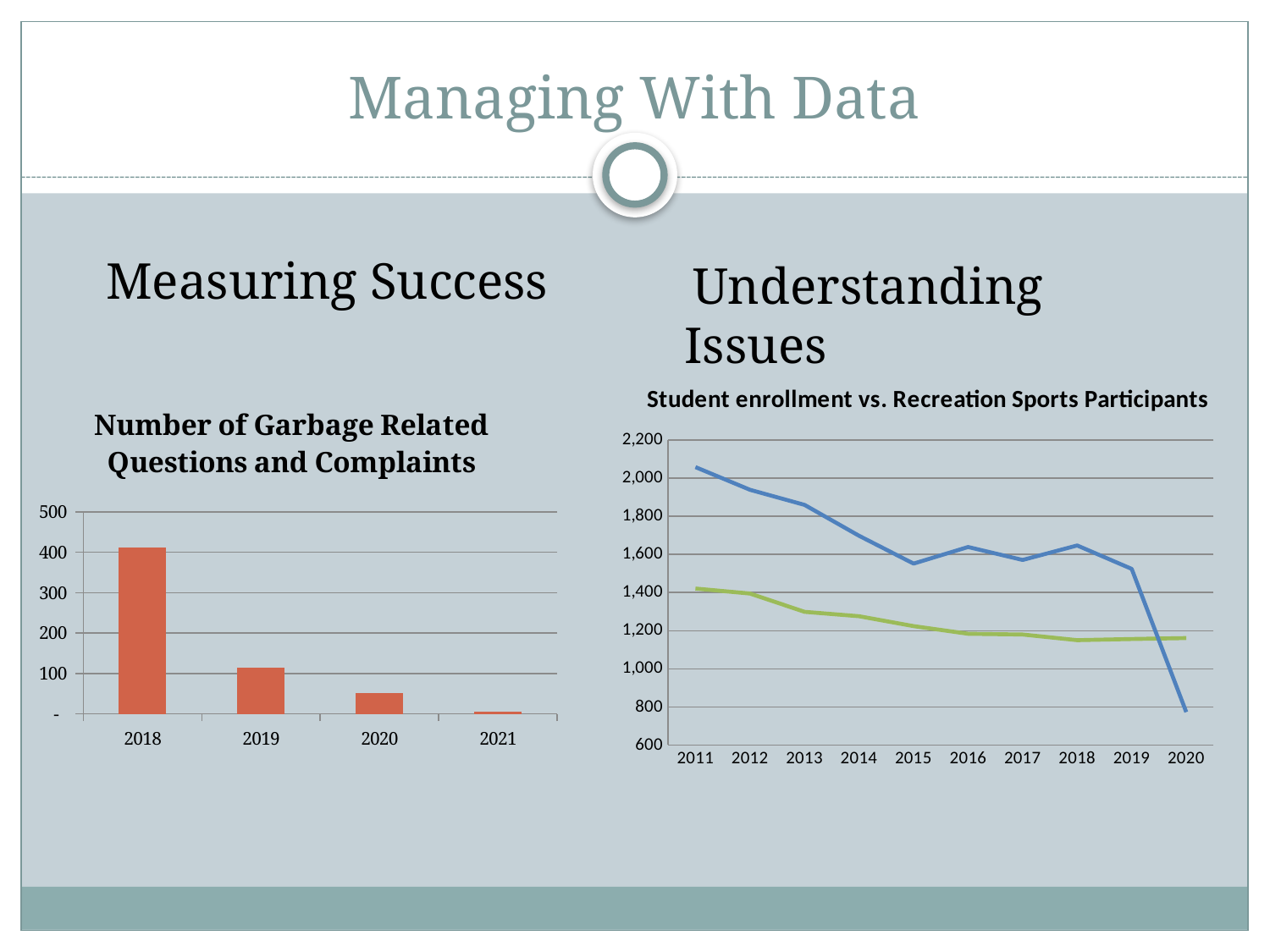
What type of chart is the 'Number of Garbage Related Questions and Complaints' chart? bar chart In the 'Student enrollment vs. Recreation Sports Participants' chart, how many lines are plotted? 2 In the 'Number of Garbage Related Questions and Complaints' chart, do the values rise or fall from 2018 to 2021? fall In the 'Student enrollment vs. Recreation Sports Participants' chart, is the blue line's value for 2020 greater or less than 800? less In the 'Number of Garbage Related Questions and Complaints' chart, is the value for 2018 greater or less than 400? greater In the 'Student enrollment vs. Recreation Sports Participants' chart, is the blue line's value for 2011 greater or less than 2,000? greater What type of chart is the 'Student enrollment vs. Recreation Sports Participants' chart? line chart In the 'Number of Garbage Related Questions and Complaints' chart, which year has the lowest value? 2021 In the 'Number of Garbage Related Questions and Complaints' chart, which year has the highest value? 2018 In the 'Number of Garbage Related Questions and Complaints' chart, how many years are shown on the x axis? 4 In the 'Student enrollment vs. Recreation Sports Participants' chart, how many years are shown on the x axis? 10